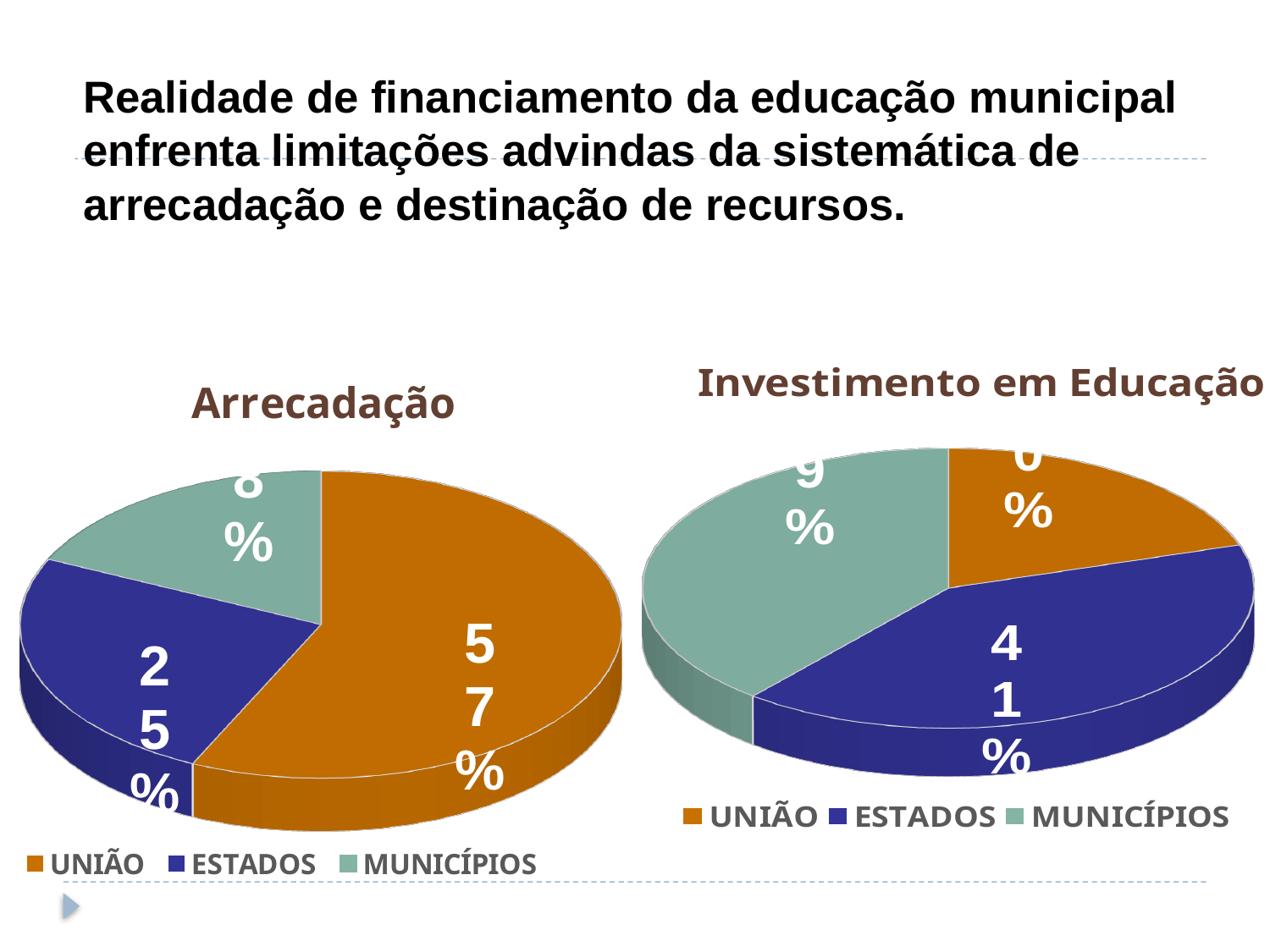
In the Investimento em Educação chart, which category has the smallest slice? UNIÃO In the Arrecadação chart, what share does ESTADOS have? 25% In the Arrecadação chart, which category has the largest slice? UNIÃO In the Investimento em Educação chart, what share does ESTADOS have? 41% In the Investimento em Educação chart, which is larger, ESTADOS or UNIÃO? ESTADOS What kind of chart is the Arrecadação chart? Pie chart In the Arrecadação chart, which category has the smallest slice? MUNICÍPIOS How many slices does the Arrecadação chart have? 3 How many entries does the legend of the Investimento em Educação chart list? 3 In the Arrecadação chart, which is larger, UNIÃO or ESTADOS? UNIÃO In the Arrecadação chart, what is the difference in percentage points between UNIÃO and ESTADOS? 32 In the Arrecadação chart, what share does UNIÃO have? 57%